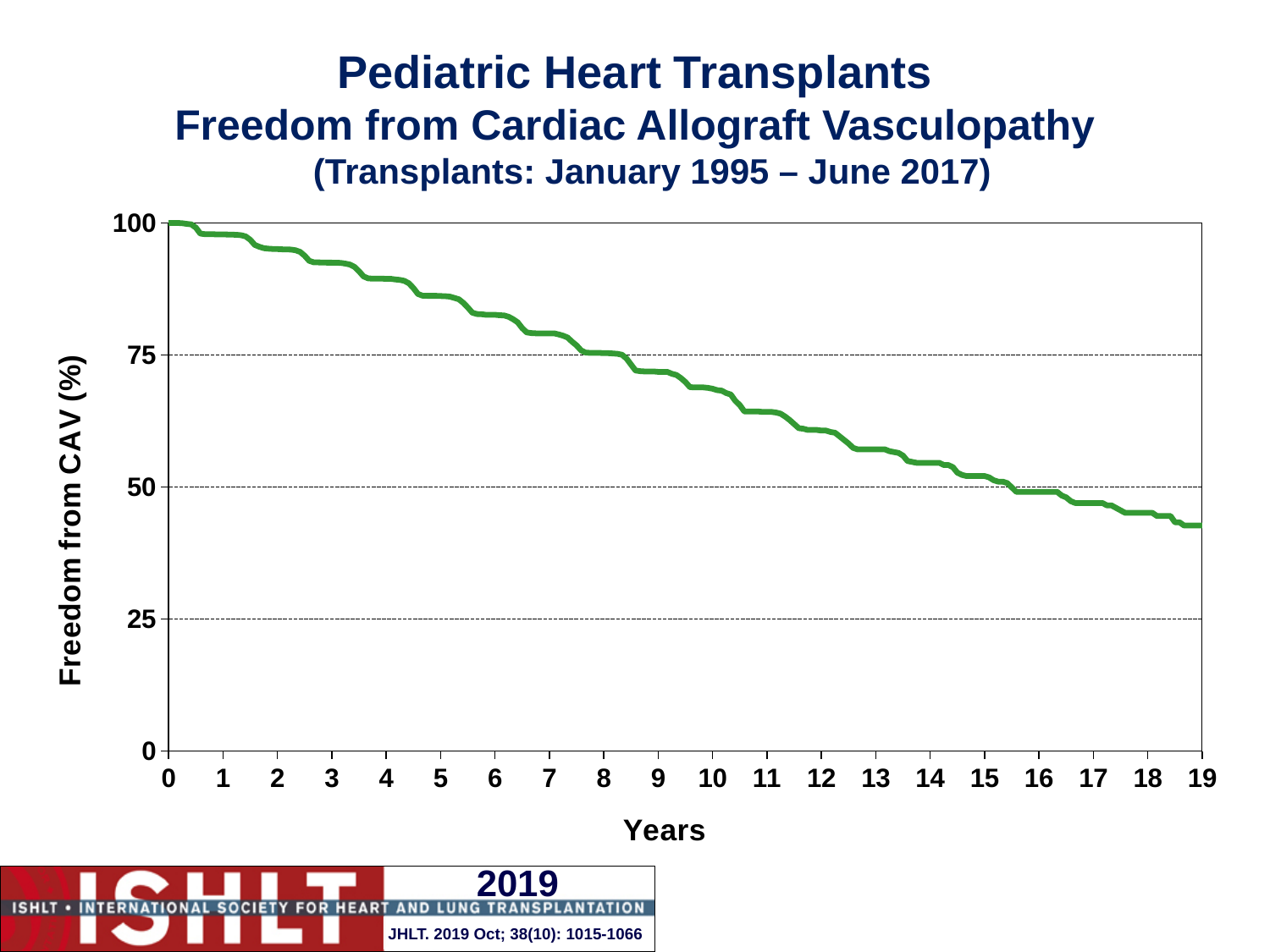
Is the freedom from CAV value at year 19 greater or less than 25? greater Which is larger, the freedom from CAV value at year 3 or at year 12? Year 3 What is the label of the y axis? Freedom from CAV (%) Is the freedom from CAV value at year 19 greater or less than 50? less Is the freedom from CAV value at year 10 greater or less than 50? greater Does freedom from CAV rise or fall as the years increase? Fall At which year on the x axis is freedom from CAV lowest? 19 What kind of chart is shown on the slide? Line chart What is the freedom from CAV value at year 0? 100 At which year on the x axis is freedom from CAV highest? 0